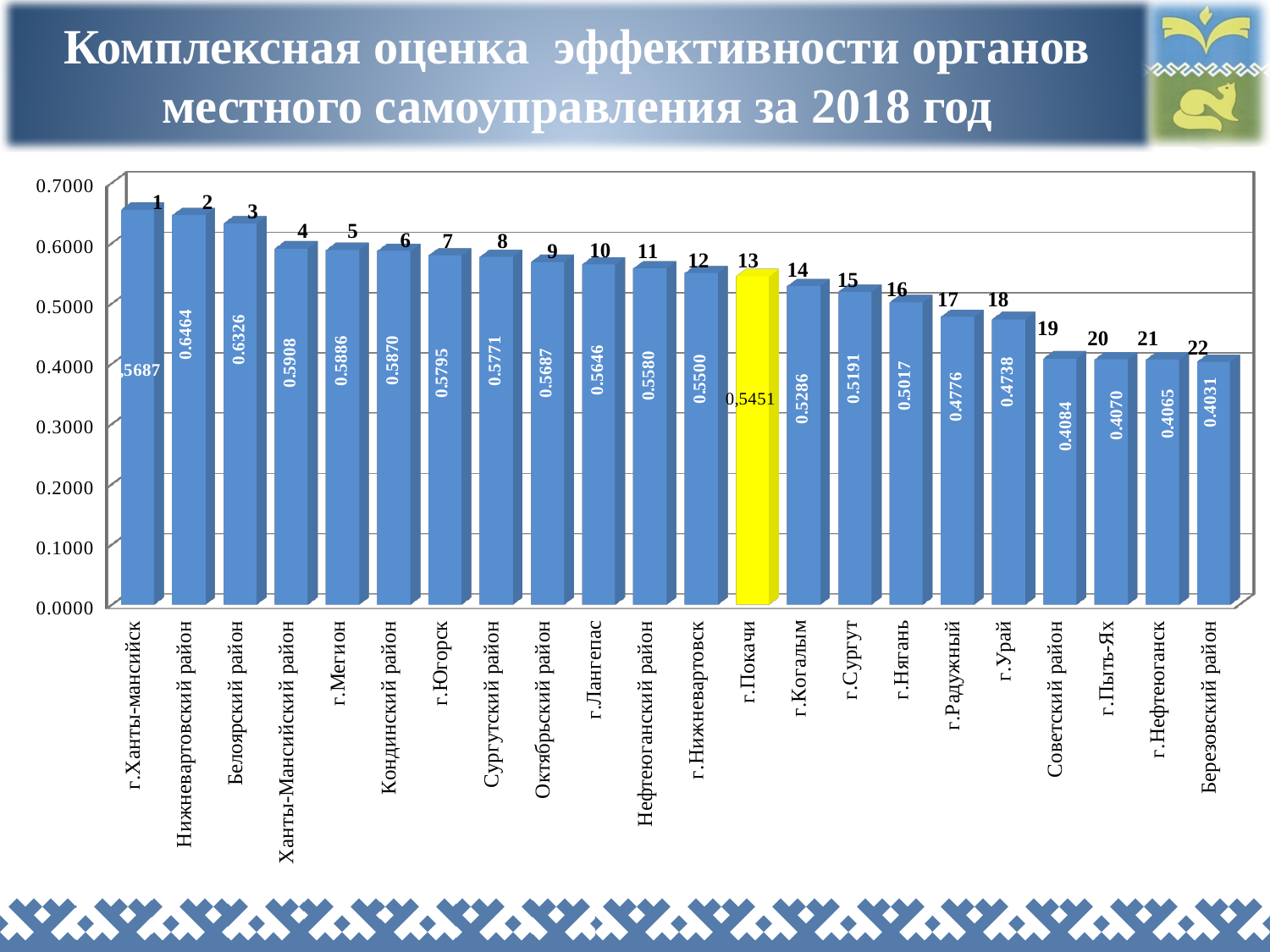
Which category has the highest value? г.Ханты-мансийск How many categories are shown on the x axis? 22 What is the value for Нижневартовский район? 0.6464 Do the values rise or fall from left to right along the x axis? fall What is the value for г.Покачи? 0,5451 Which is larger, the value for г.Мегион or the value for г.Югорск? г.Мегион Which category's bar is coloured yellow? г.Покачи What is the value for г.Радужный? 0.4776 Which category has the lowest value? Березовский район Is the value for г.Урай greater or less than 0.5000? less What is the difference between the values for Нижневартовский район and Белоярский район? 0.0138 What kind of chart is shown on the slide? bar chart